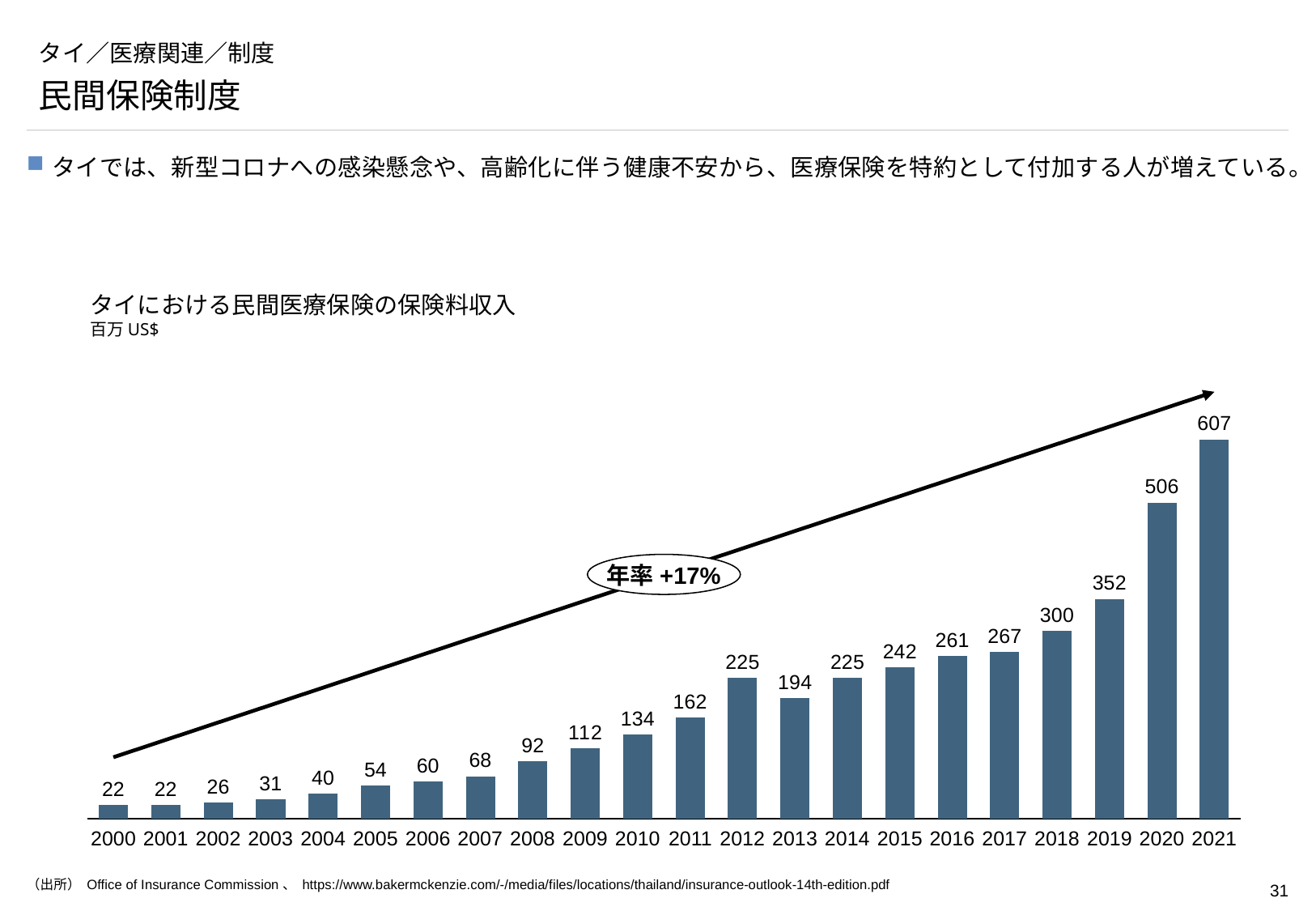
What is the value for 2000? 22 What is the value for 2021? 607 What is the difference between the values for 2021 and 2020? 101 What kind of chart is this? bar chart What is the value for 2012? 225 What annual growth rate is shown in the label on the arrow? 年率 +17% Which year has the lowest value? 2000 and 2001 How many years are shown on the x axis? 22 Which year has the highest value? 2021 What unit is stated under the chart title? 百万 US$ Which is larger, the value for 2013 or the value for 2014? 2014 Do the values generally rise or fall from 2000 to 2021? rise